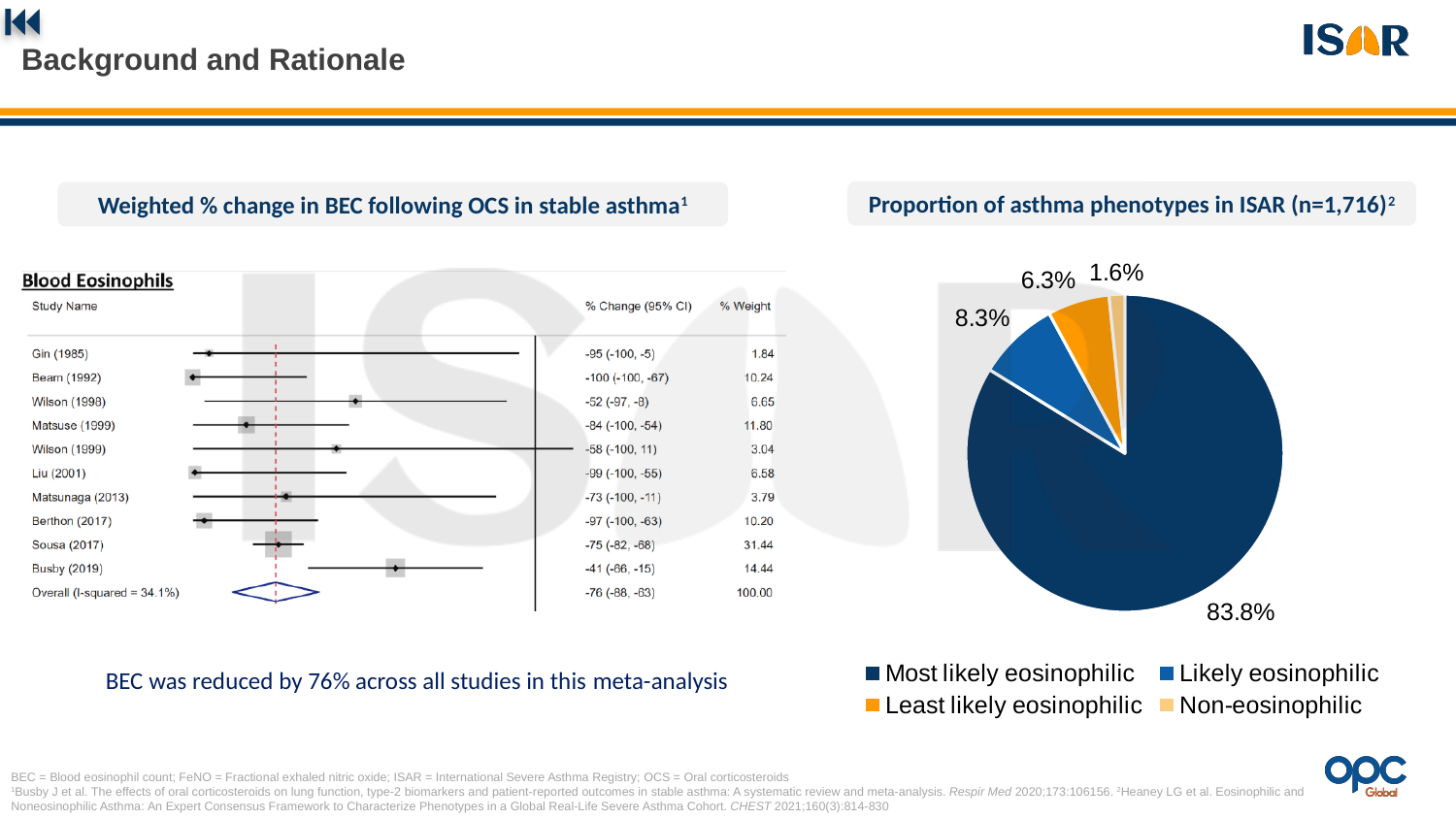
In the 'Proportion of asthma phenotypes in ISAR (n=1,716)' pie chart, which phenotype has the largest slice? Most likely eosinophilic In the 'Proportion of asthma phenotypes in ISAR (n=1,716)' pie chart, which is larger: Likely eosinophilic or Least likely eosinophilic? Likely eosinophilic In the 'Weighted % change in BEC following OCS in stable asthma' forest plot, which study has the highest % weight? Sousa (2017) In the 'Proportion of asthma phenotypes in ISAR (n=1,716)' pie chart, what share is labelled for Non-eosinophilic? 1.6% In the 'Proportion of asthma phenotypes in ISAR (n=1,716)' pie chart, what is the difference in percentage points between Least likely eosinophilic and Non-eosinophilic? 4.7 In the 'Weighted % change in BEC following OCS in stable asthma' forest plot, what is the overall % change (95% CI)? -76 (-88, -63) In the 'Proportion of asthma phenotypes in ISAR (n=1,716)' pie chart, what share is labelled for Most likely eosinophilic? 83.8% In the 'Weighted % change in BEC following OCS in stable asthma' forest plot, how many individual studies are listed (excluding the Overall row)? 10 In the 'Proportion of asthma phenotypes in ISAR (n=1,716)' pie chart, which phenotype has the smallest slice? Non-eosinophilic In the 'Proportion of asthma phenotypes in ISAR (n=1,716)' pie chart, what share is labelled for Likely eosinophilic? 8.3% In the 'Proportion of asthma phenotypes in ISAR (n=1,716)' chart, what kind of chart is shown? Pie chart In the 'Proportion of asthma phenotypes in ISAR (n=1,716)' pie chart, how many categories does the legend list? 4